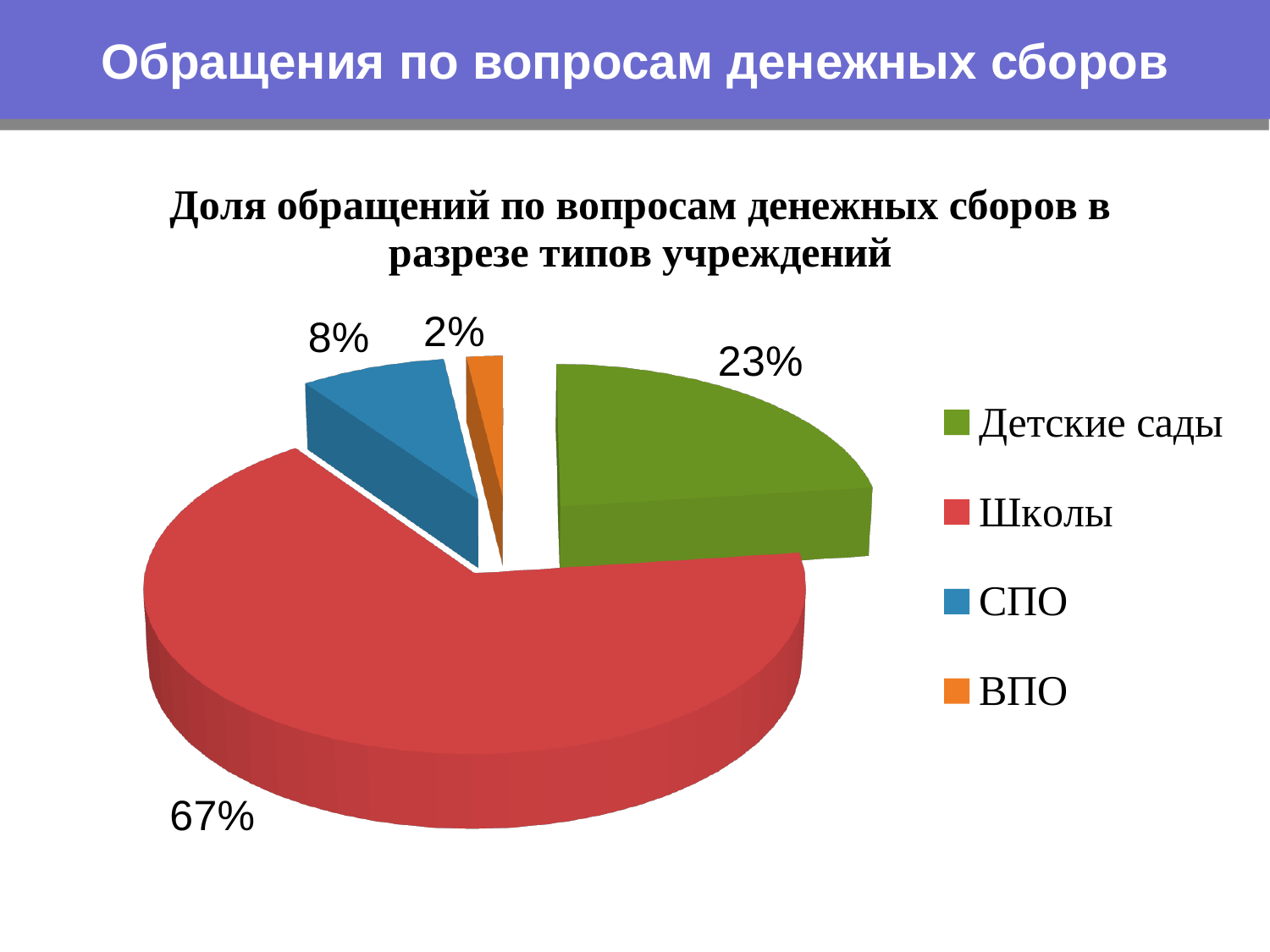
Which category has the largest slice of the pie? Школы What share of the pie does Школы account for? 67% What kind of chart is shown on the slide? Pie chart What is the value shown for Детские сады? 23% Which category has the smallest slice of the pie? ВПО What is the difference between the shares of Школы and Детские сады? 44% What is the value shown for ВПО? 2% How many categories does the pie chart show? 4 Which is larger, the share for СПО or the share for ВПО? СПО Which colour represents Детские сады in the legend? Green What is the value shown for СПО? 8% What is the title of the chart? Доля обращений по вопросам денежных сборов в разрезе типов учреждений